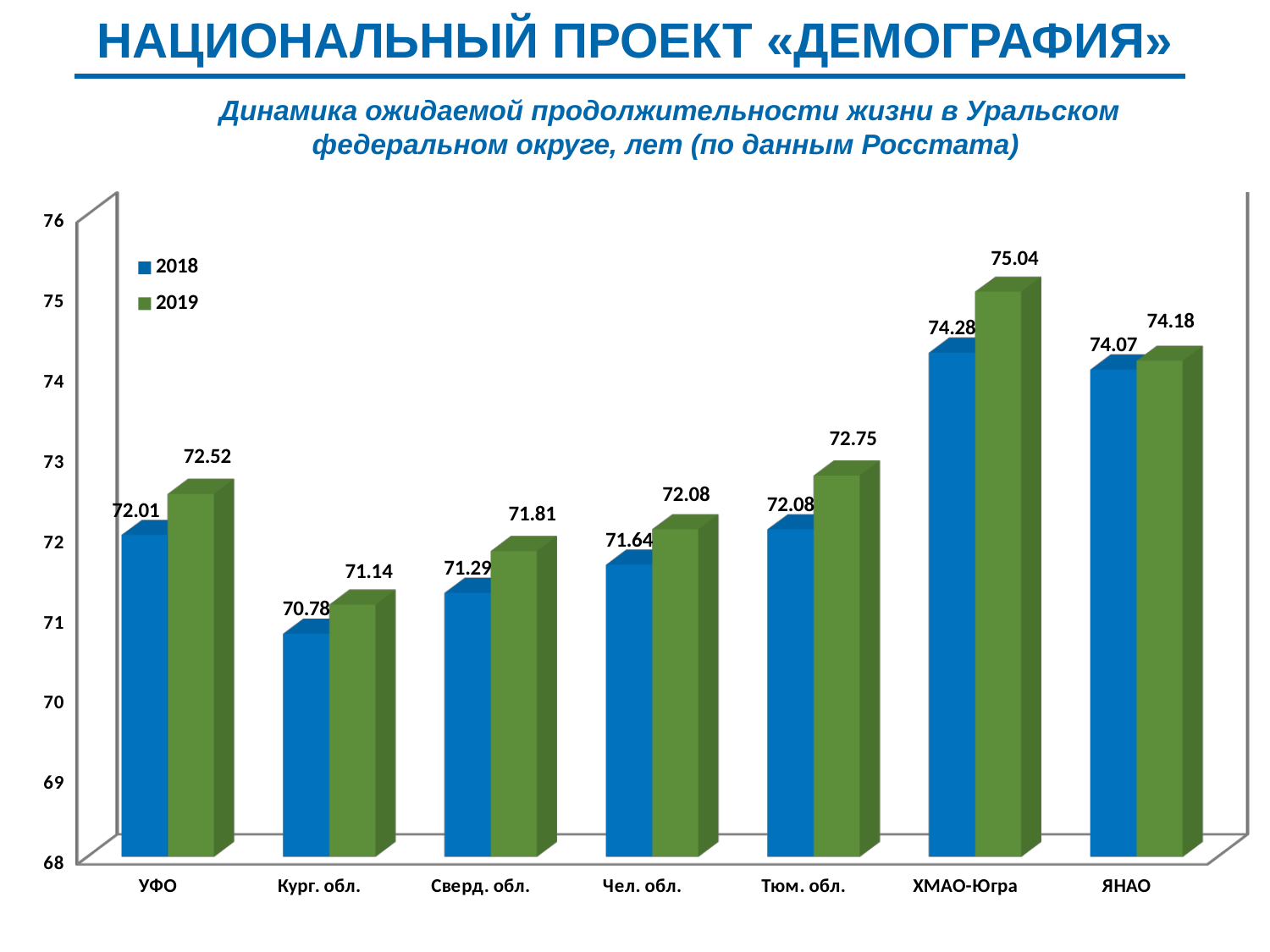
Which region has the lowest value in 2018? Кург. обл. What is the expected life expectancy for ХМАО-Югра in 2019? 75.04 Which is larger: the 2018 value for УФО or the 2018 value for Сверд. обл.? УФО How many series does the legend list? 2 What is the value for Кург. обл. in 2018? 70.78 How many regions (categories) are shown on the x axis? 7 Is the 2019 value for Сверд. обл. greater or less than 72? less What is the difference between the 2019 and 2018 values for ЯНАО? 0.11 What is the value for Тюм. обл. in 2019? 72.75 By how much did the value for ХМАО-Югра increase from 2018 to 2019? 0.76 Which region has the highest value in 2019? ХМАО-Югра What kind of chart is shown on the slide? bar chart